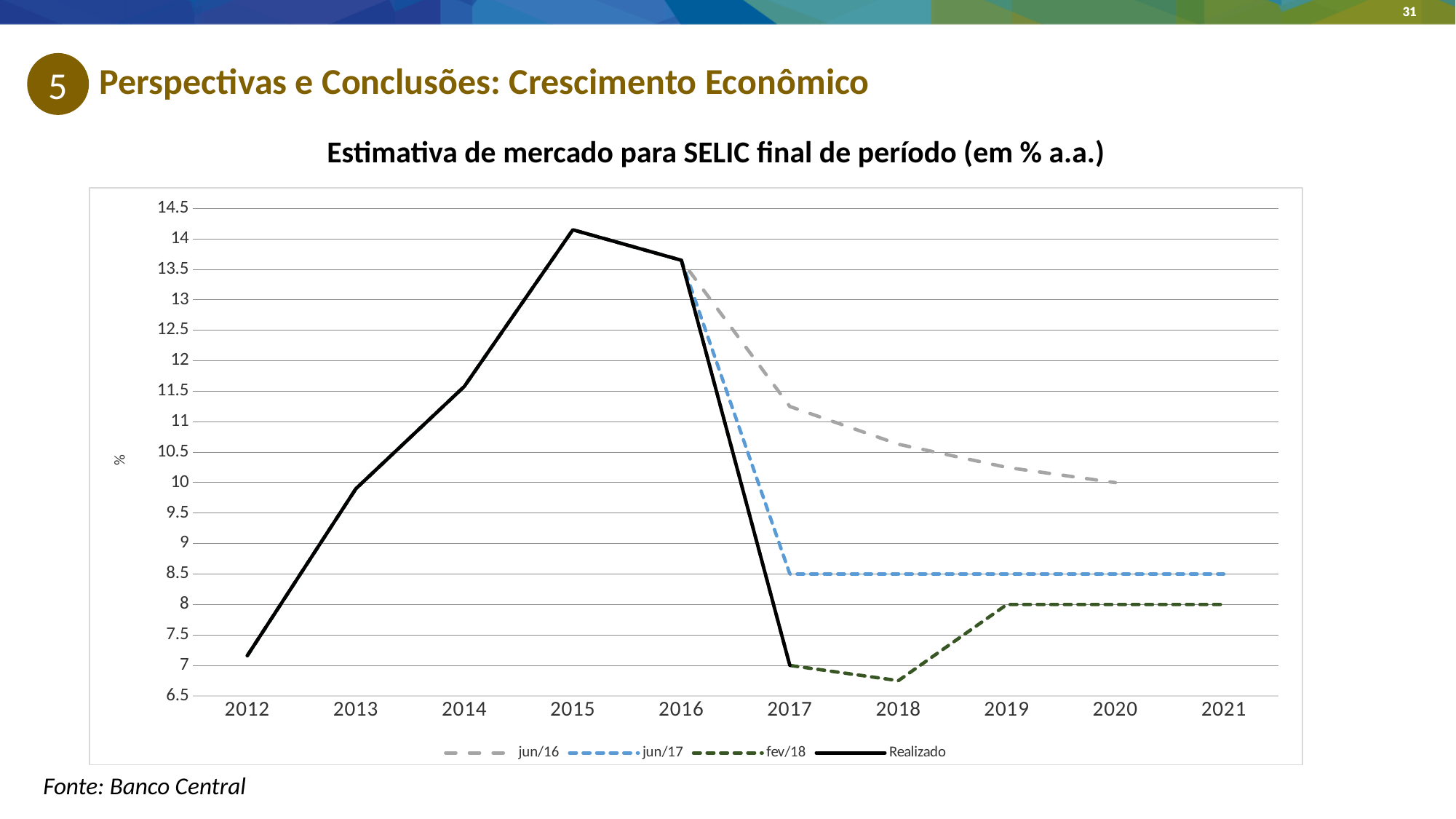
In which year does the Realizado series reach its highest value? 2015 Is the Realizado value for 2015 greater or less than 14? greater Which series is drawn as a solid black line? Realizado What is the title of the chart? Estimativa de mercado para SELIC final de período (em % a.a.) Which series has the lowest value in 2018? fev/18 Is the jun/16 value for 2017 greater or less than 11? greater Is the Realizado value for 2012 greater or less than 7.5? less How many years are shown on the x axis? 10 What kind of chart is shown on the slide? line chart How many series does the legend list? 4 Does the Realizado series rise or fall between 2012 and 2015? rise Which series has the higher value in 2020, jun/16 or jun/17? jun/16